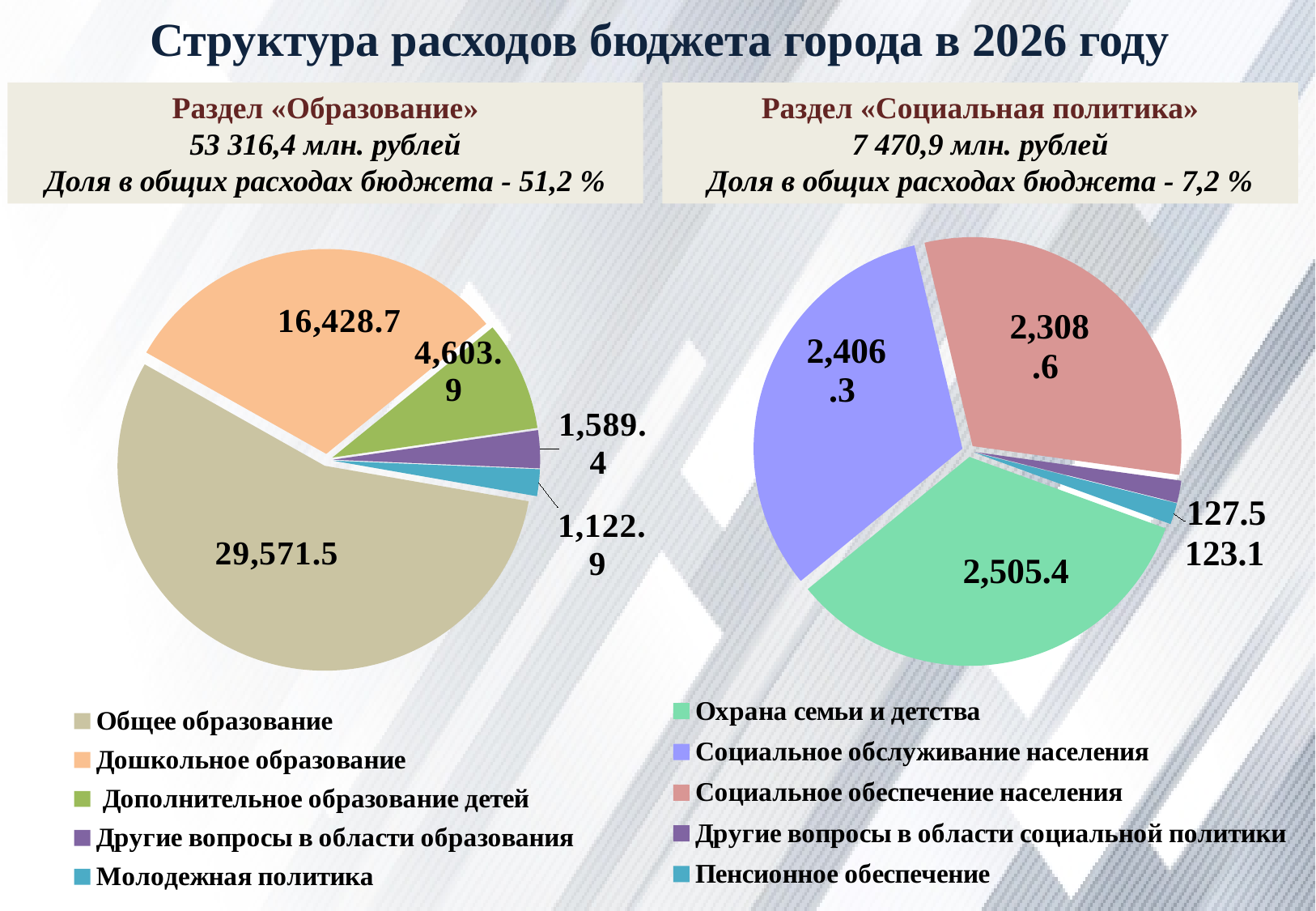
In the left pie chart (Раздел «Образование»), what is the value for Молодежная политика? 1,122.9 In the right pie chart (Раздел «Социальная политика»), what is the value for Пенсионное обеспечение? 123.1 In the left pie chart (Раздел «Образование»), what is the difference between Общее образование and Дошкольное образование? 13,142.8 In the right pie chart (Раздел «Социальная политика»), which is larger: Социальное обслуживание населения or Социальное обеспечение населения? Социальное обслуживание населения In the left pie chart (Раздел «Образование»), which category has the smallest value? Молодежная политика In the right pie chart (Раздел «Социальная политика»), what is the value for Охрана семьи и детства? 2,505.4 In the left pie chart (Раздел «Образование»), what is the value for Общее образование? 29,571.5 What type of chart is used on the left (Раздел «Образование»)? Pie chart How many categories does the legend of the left pie chart (Раздел «Образование») list? 5 In the left pie chart (Раздел «Образование»), what is the value for Дошкольное образование? 16,428.7 In the right pie chart (Раздел «Социальная политика»), which category has the largest value? Охрана семьи и детства In the right pie chart (Раздел «Социальная политика»), what is the difference between Другие вопросы в области социальной политики and Пенсионное обеспечение? 4.4